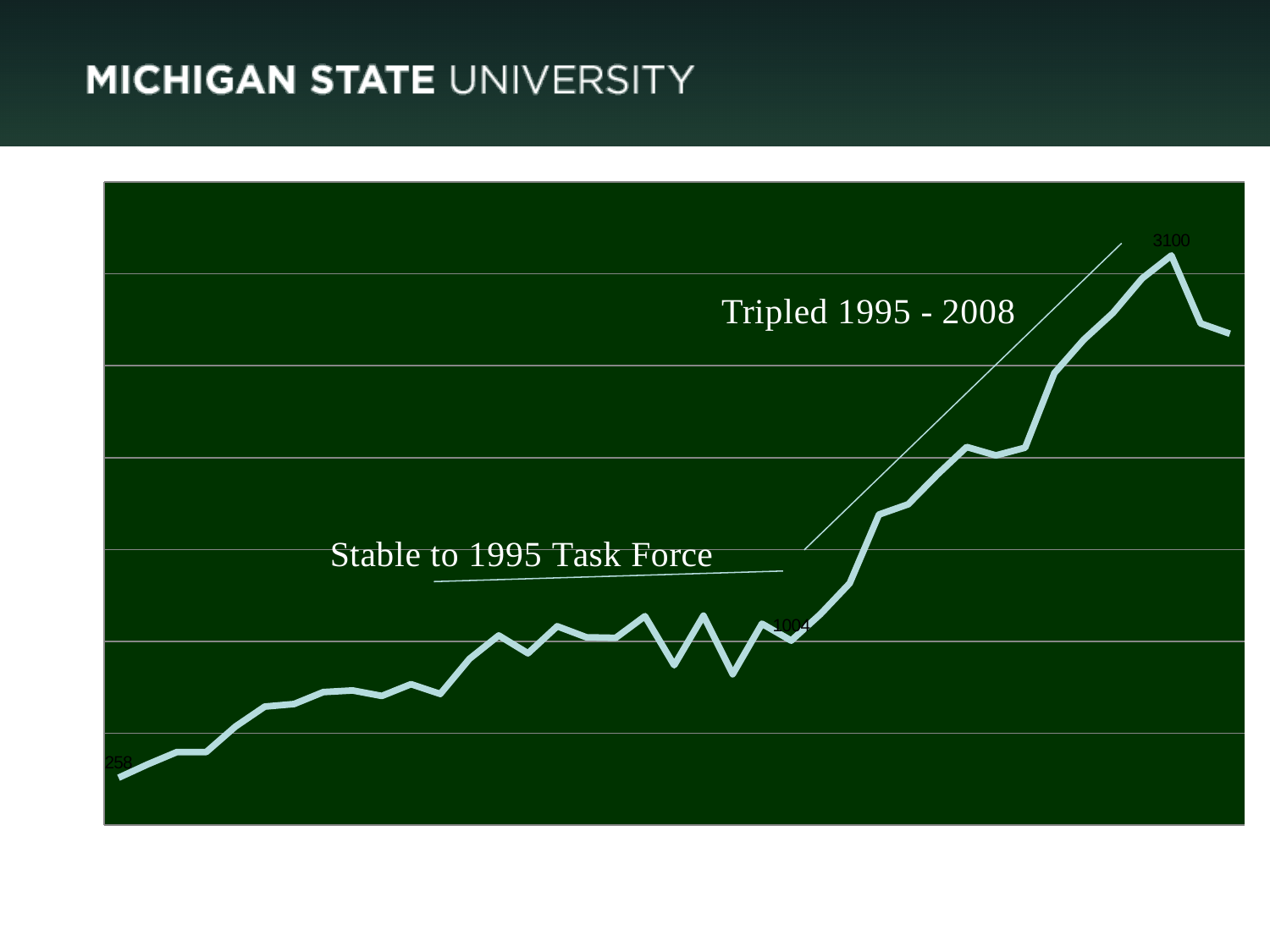
What is the data label on the point near the end of the 'Stable to 1995 Task Force' period? 1004 Overall, does the line rise or fall from left to right? rise What is the difference between the labeled values 3100 and 1004? 2096 What does the annotation in the upper right of the chart say? Tripled 1995 - 2008 What is the highest labeled value on the chart? 3100 What is the difference between the peak value 3100 and the starting value 258? 2842 What is the difference between the labeled values 1004 and 258? 746 What is the lowest labeled value on the chart? 258 Is the final point of the line higher or lower than the peak labeled 3100? lower What is the data label at the peak of the line? 3100 What kind of chart is shown on the slide? line chart What is the data label on the first point of the line? 258